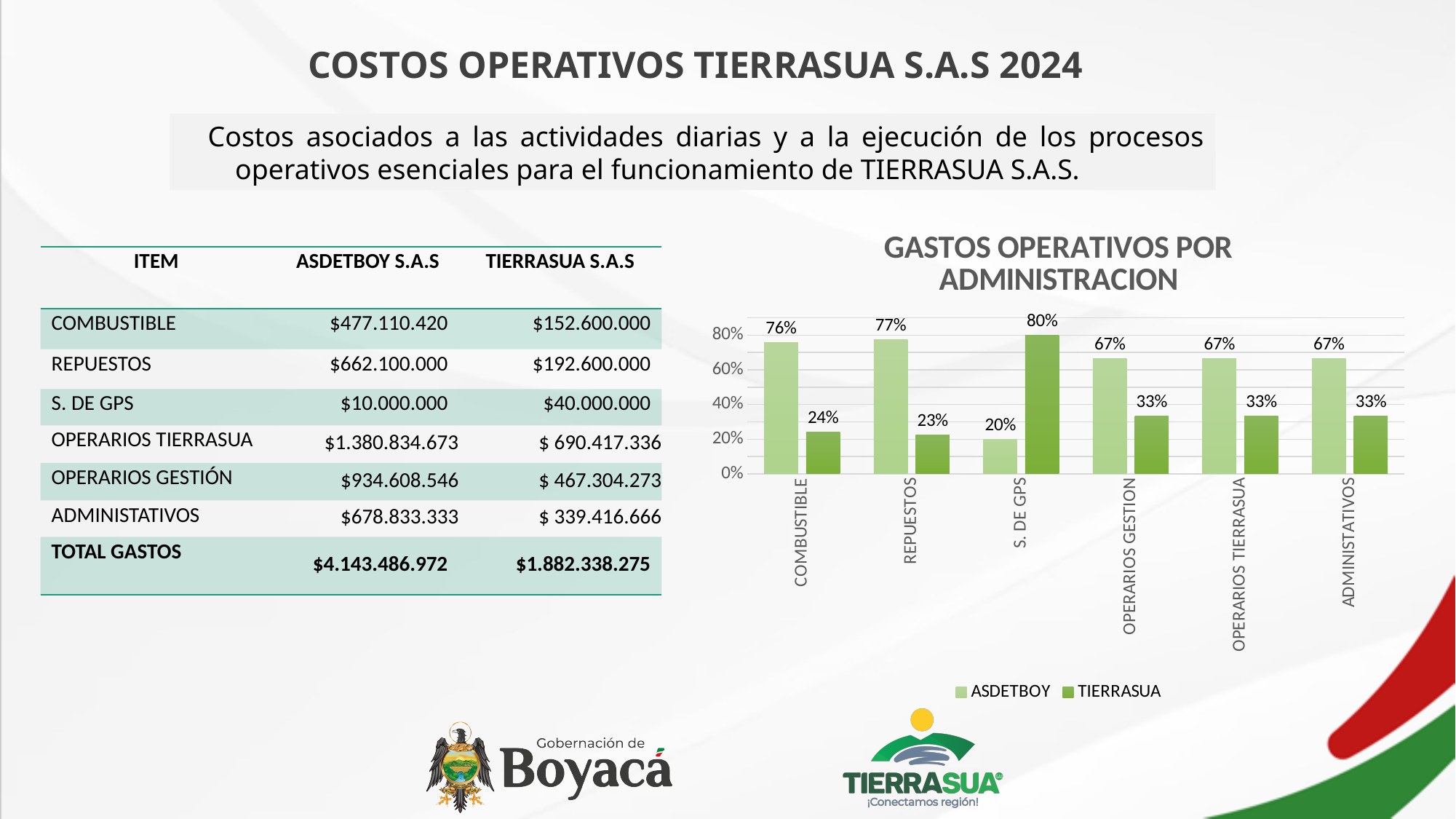
What is the ASDETBOY value for OPERARIOS GESTION in the chart? 67% What is the TIERRASUA value for S. DE GPS in the chart? 80% What is the TIERRASUA value for REPUESTOS in the chart? 23% What is the title of the chart on the slide? GASTOS OPERATIVOS POR ADMINISTRACION For which category is the TIERRASUA value highest in the chart? S. DE GPS How many categories are shown on the x axis of the chart? 6 What kind of chart is shown on the slide? Bar chart What is the ASDETBOY value for COMBUSTIBLE in the chart? 76% What is the difference between the ASDETBOY and TIERRASUA values for COMBUSTIBLE? 52% How many series does the chart legend list? 2 For which category is the ASDETBOY value lowest in the chart? S. DE GPS Which is larger for S. DE GPS: the ASDETBOY value or the TIERRASUA value? TIERRASUA